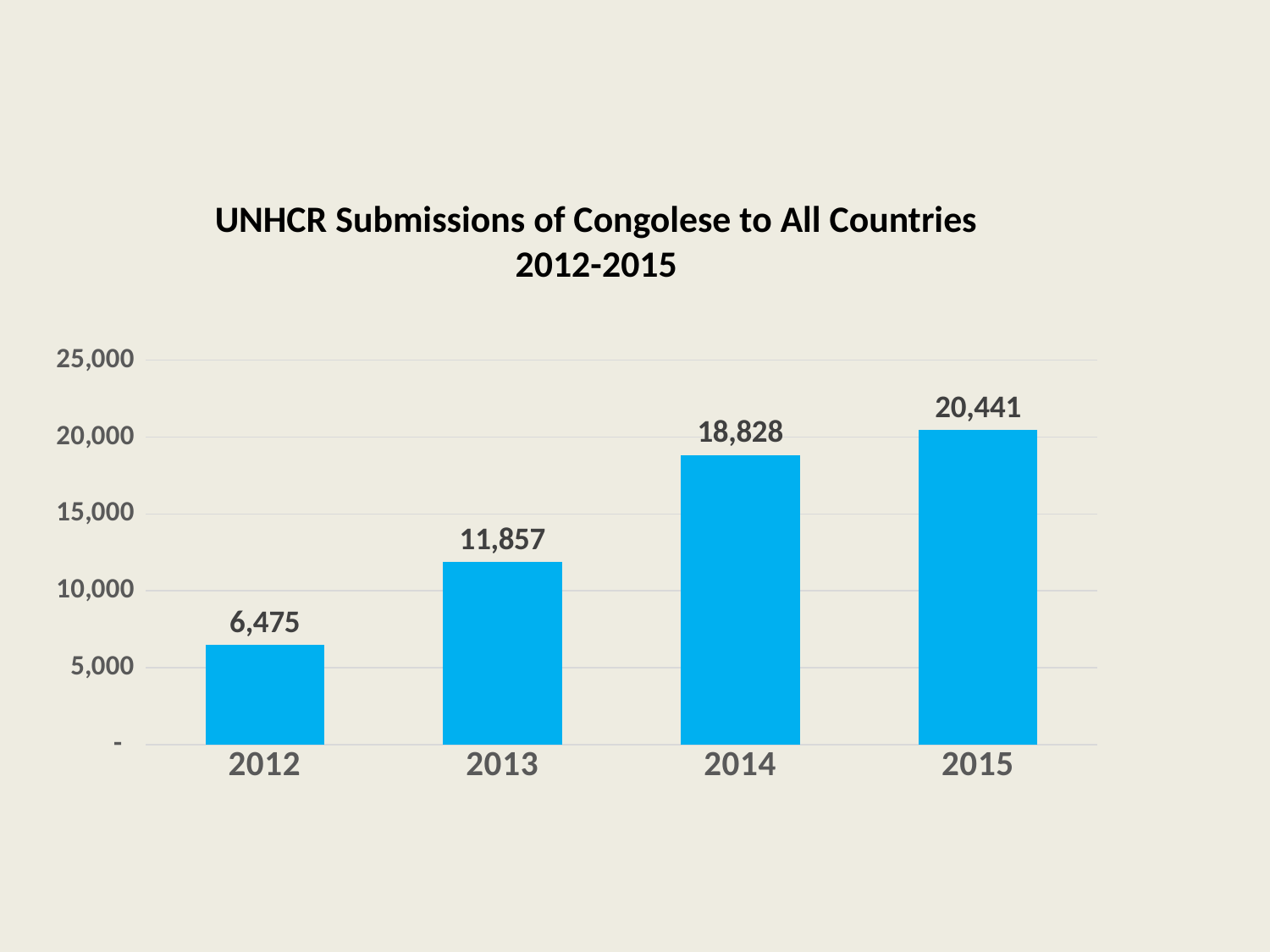
What is the difference between the values for 2014 and 2013? 6,971 What is the value for 2013? 11,857 How many years are shown on the chart? 4 Which is larger, the value for 2013 or the value for 2014? 2014 What is the difference between the values for 2015 and 2012? 13,966 What is the value for 2012? 6,475 Do the values rise or fall from 2012 to 2015? Rise What is the value for 2015? 20,441 What kind of chart is this? Bar chart Which year has the highest value? 2015 Which year has the lowest value? 2012 What is the value for 2014? 18,828